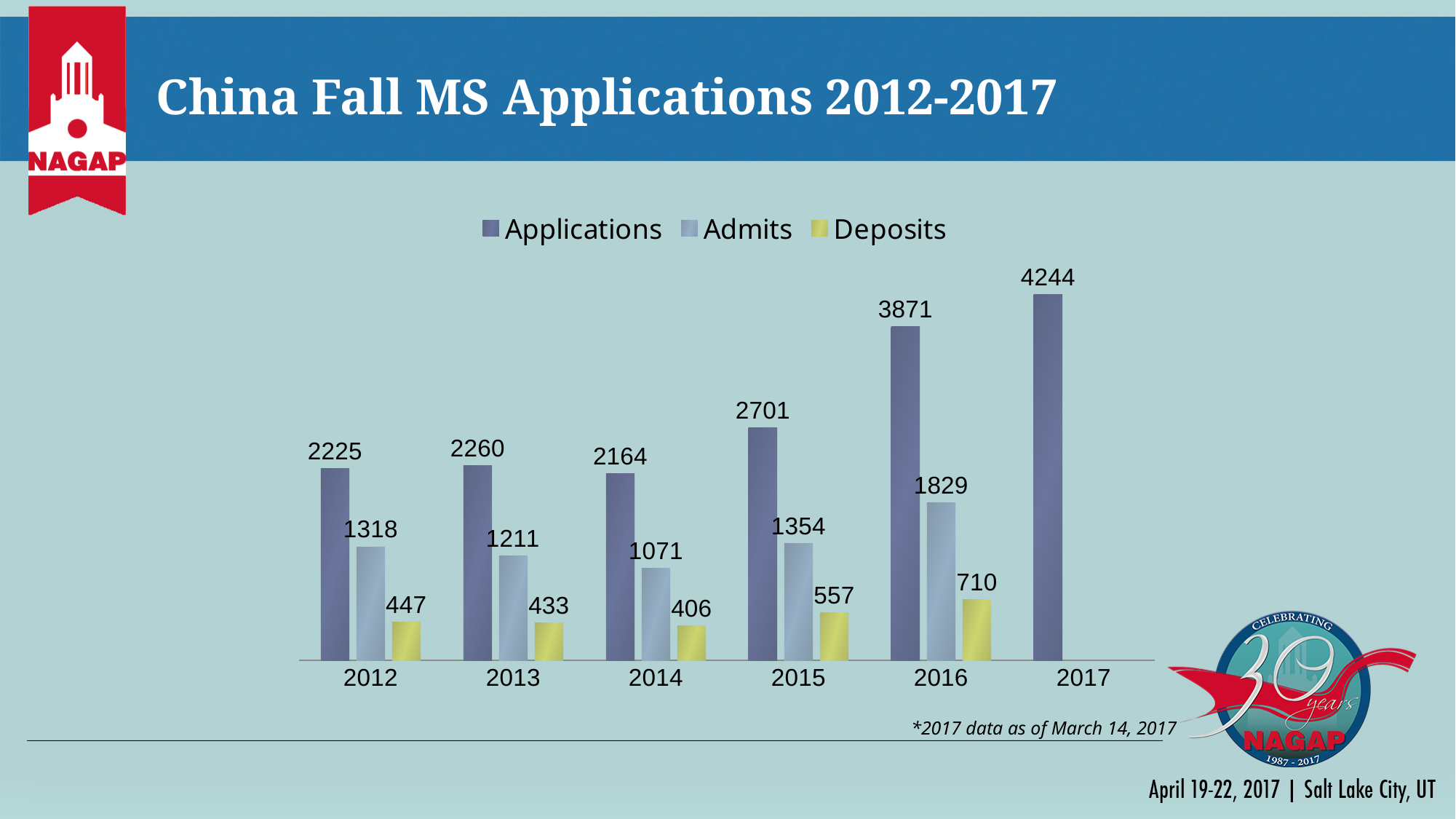
How many years are shown on the x axis? 6 Do Applications rise or fall from 2014 to 2017? Rise What is the difference between Applications in 2016 and Applications in 2015? 1170 Which year has the highest number of Applications? 2017 What is the number of Applications in 2017? 4244 What is the number of Admits in 2014? 1071 What is the title of the chart? China Fall MS Applications 2012-2017 How many series does the legend list? 3 Which is larger: Admits in 2012 or Admits in 2013? Admits in 2012 What kind of chart is shown on the slide? Bar chart What is the number of Deposits in 2015? 557 Which year has the lowest number of Deposits? 2014